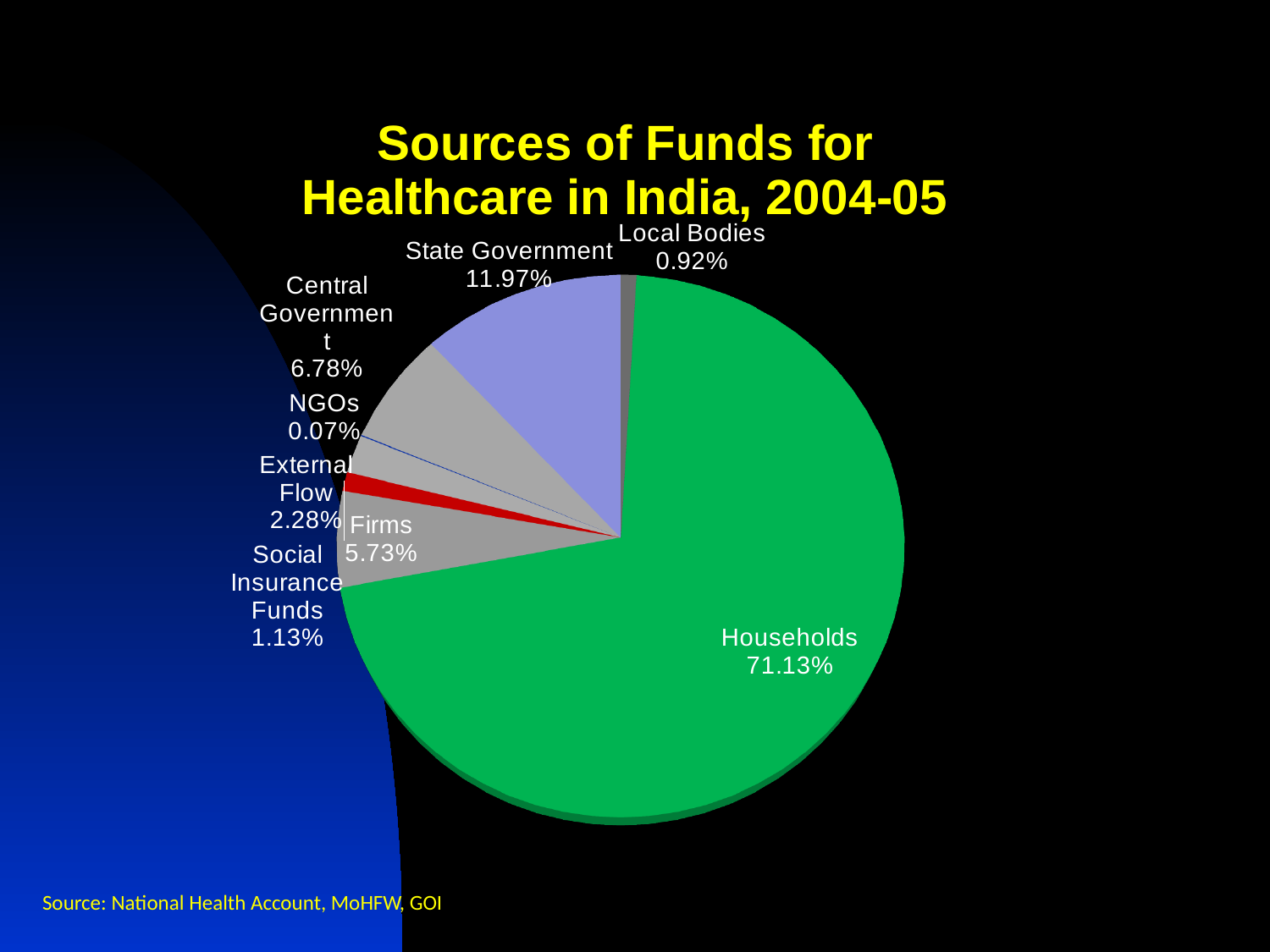
What share of healthcare funds comes from Central Government? 6.78% What share of healthcare funds comes from Firms? 5.73% What kind of chart is shown on the slide? Pie chart What share of healthcare funds comes from Households? 71.13% What share of healthcare funds comes from State Government? 11.97% What is the difference between the State Government share and the Central Government share? 5.19% Which source of funds has the smallest share of the pie? NGOs What share of healthcare funds comes from NGOs? 0.07% Which source of funds has the largest share of the pie? Households What is the title of the chart? Sources of Funds for Healthcare in India, 2004-05 Which is larger, the share for External Flow or the share for Social Insurance Funds? External Flow How many sources of funds are shown in the pie chart? 8